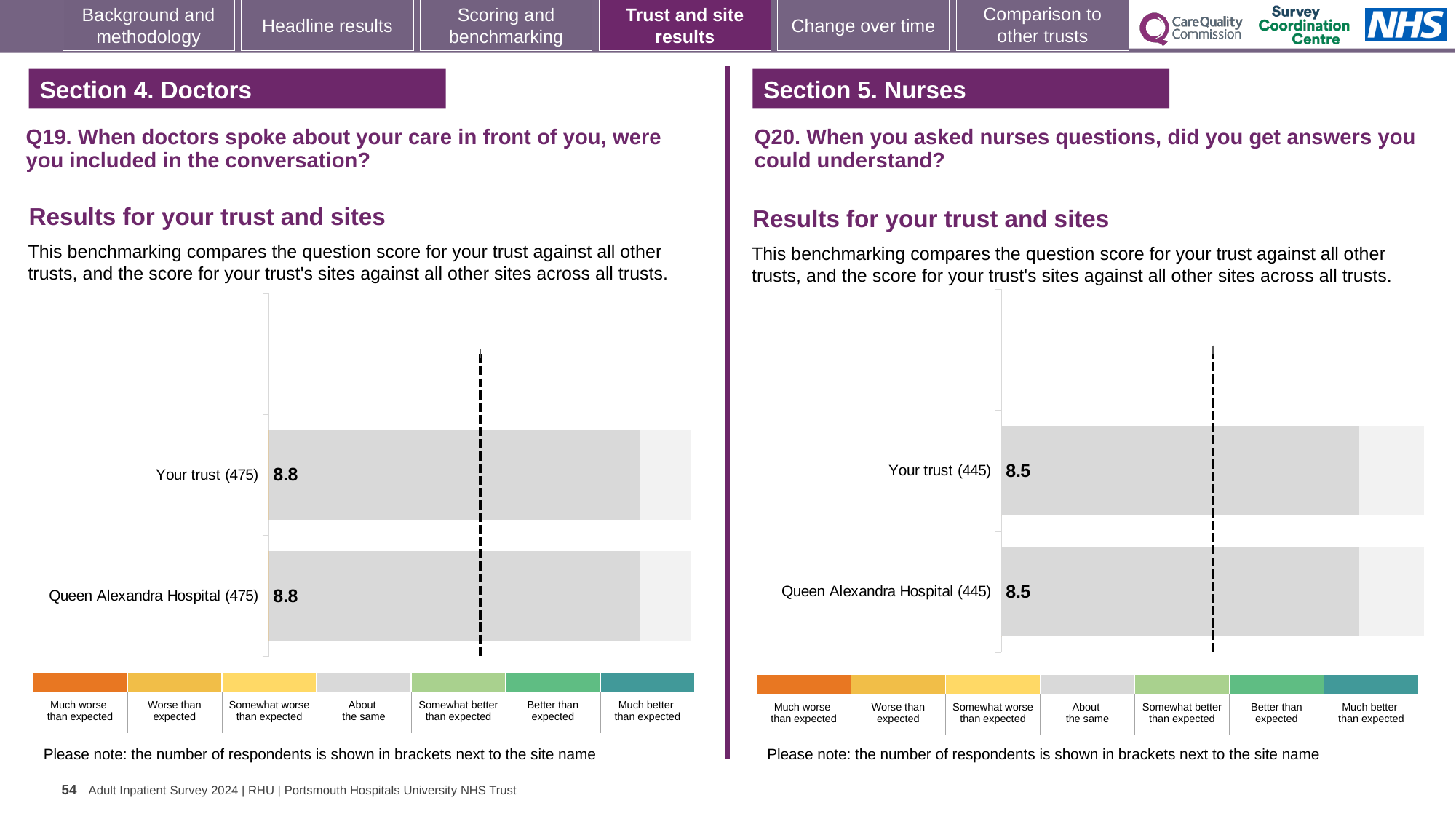
In the Q20 chart on the right, what is the score for Queen Alexandra Hospital? 8.5 In the Q20 chart on the right, what is the difference between the score for Your trust and the score for Queen Alexandra Hospital? 0 How many bars are plotted in the Q19 chart on the left? 2 In the Q19 chart on the left, what is the score for Your trust? 8.8 In the Q19 chart on the left, what is the score for Queen Alexandra Hospital? 8.8 In the Q20 chart on the right, what is the score for Your trust? 8.5 In the Q19 chart on the left, what is the difference between the score for Your trust and the score for Queen Alexandra Hospital? 0 In the Q19 chart on the left, how many respondents are shown in brackets next to Your trust? 475 In the Q20 chart on the right, how many respondents are shown in brackets next to Queen Alexandra Hospital? 445 How many bars are plotted in the Q20 chart on the right? 2 Is the score for Your trust in the Q19 chart on the left larger than the score for Your trust in the Q20 chart on the right? Yes What kind of chart is used for the Q19 results on the left? Bar chart